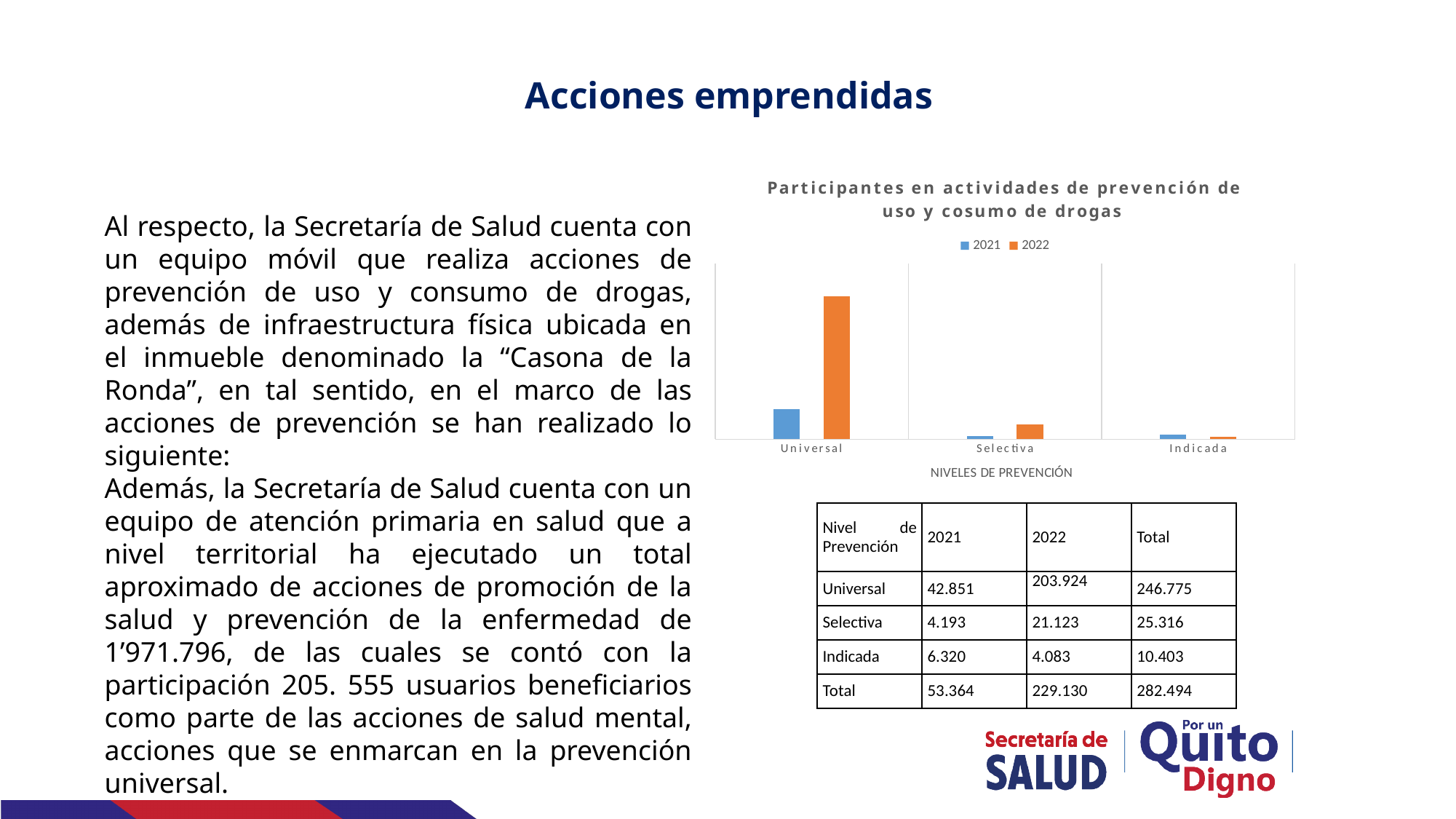
Do the 2022 values rise or fall from Universal to Indicada along the x axis? fall According to the table below the chart, what is the value for Selectiva in 2021? 4.193 For the Universal category, which series has the larger value, 2021 or 2022? 2022 Which category has the tallest bar in the chart? Universal How many categories are shown on the x axis of the chart? 3 According to the table below the chart, what is the value for Universal in 2022? 203.924 What kind of chart is shown on the slide? bar chart What is the x-axis title of the chart? NIVELES DE PREVENCIÓN Which category has the lowest value for the 2022 series? Indicada What is the title of the chart? Participantes en actividades de prevención de uso y cosumo de drogas How many series does the chart's legend list? 2 For the Indicada category, which series has the larger value, 2021 or 2022? 2021